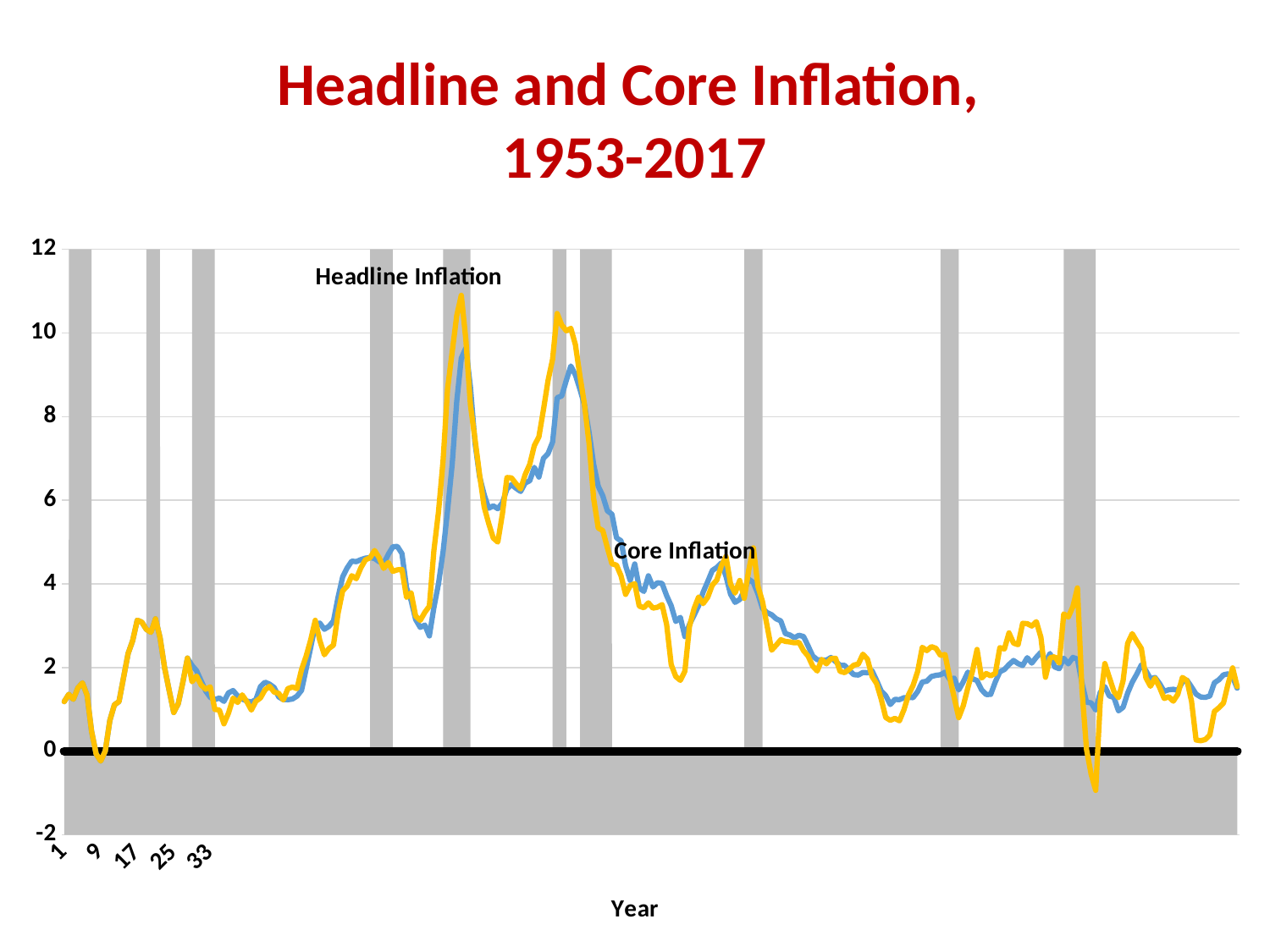
What kind of chart is shown on the slide? Line chart Is the lowest value reached by the Headline Inflation line greater or less than 0? less How many data series are plotted on the chart? 2 Which series reaches the higher peak, Headline Inflation or Core Inflation? Headline Inflation Is the highest value reached by the Core Inflation line greater or less than 8? greater Is the highest value reached by the Core Inflation line greater or less than 10? less What colour is the Headline Inflation line? Yellow Which series drops to the lower minimum, Headline Inflation or Core Inflation? Headline Inflation What is the title of the chart? Headline and Core Inflation, 1953-2017 From the highest peak of the Core Inflation line to the right end of the chart, do the values generally rise or fall? Fall